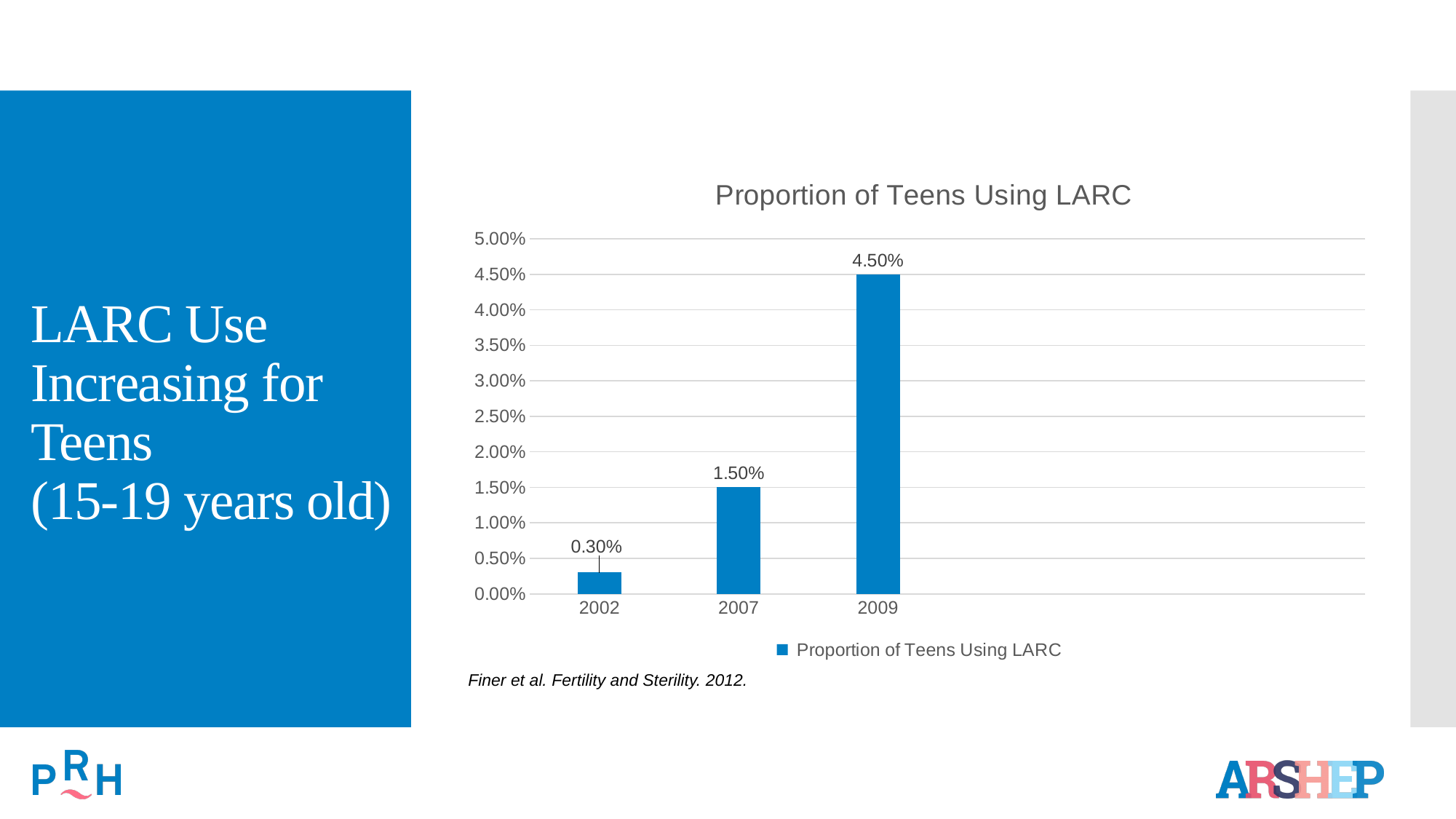
Is the value for 2009 greater or less than 4.00%? greater What is the difference between the proportion of teens using LARC in 2007 and in 2002? 1.20% Which year has the lowest proportion of teens using LARC? 2002 Which year has a larger proportion of teens using LARC, 2002 or 2007? 2007 Which year has the highest proportion of teens using LARC? 2009 What is the proportion of teens using LARC in 2009? 4.50% What is the proportion of teens using LARC in 2002? 0.30% What is the difference between the proportion of teens using LARC in 2009 and in 2007? 3.00% What is the proportion of teens using LARC in 2007? 1.50% What kind of chart is shown on the slide? Bar chart Do the values rise or fall from 2002 to 2009? Rise How many years are shown on the x axis of the chart? 3